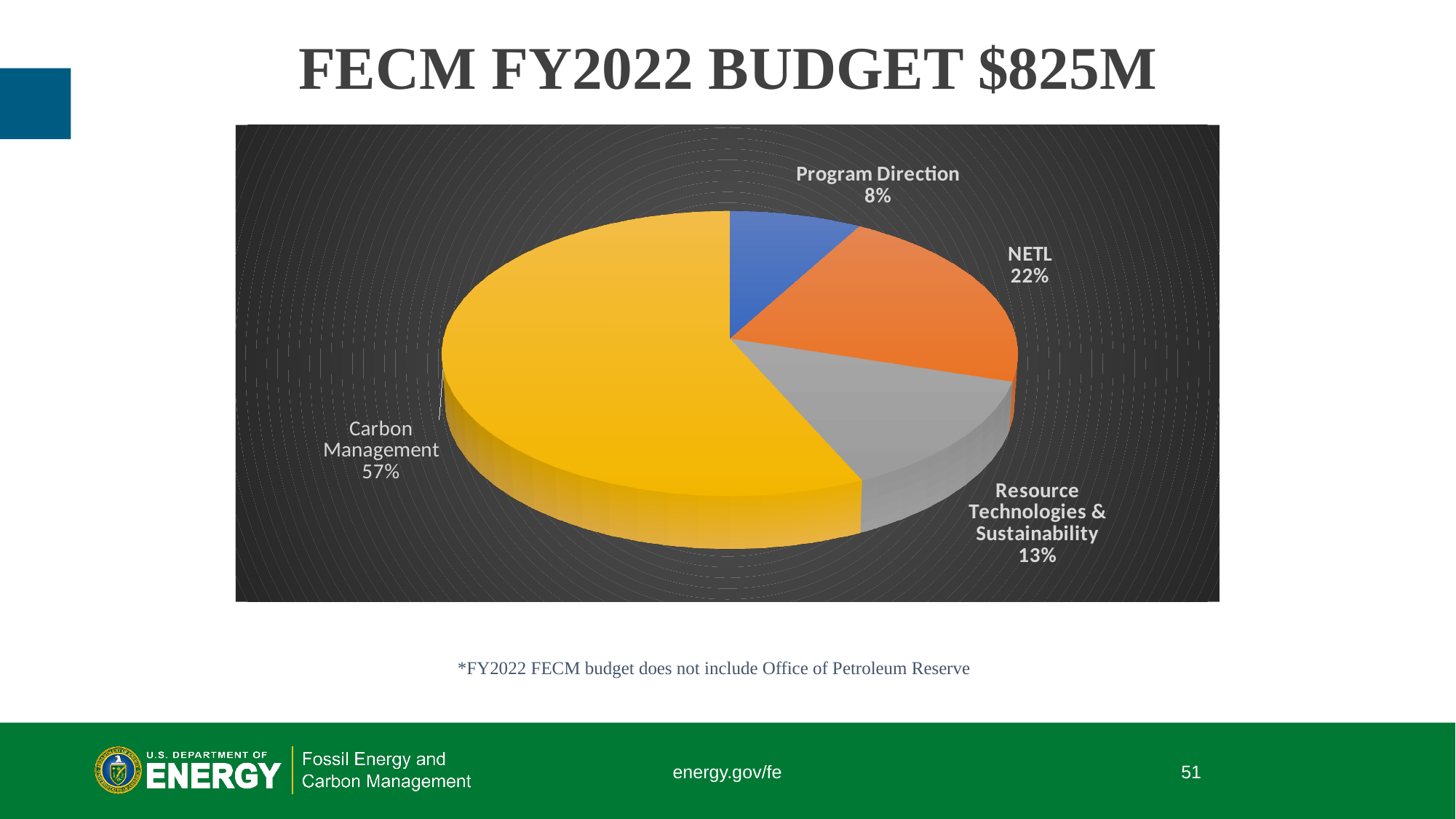
What share of the FECM FY2022 budget goes to Carbon Management? 57% What is the difference in percentage points between Carbon Management and NETL? 35 What is the difference in percentage points between Resource Technologies & Sustainability and Program Direction? 5 How many categories are shown in the pie chart? 4 What kind of chart is shown on the slide? Pie chart What percentage of the budget is for Program Direction? 8% Which category has the largest share of the budget? Carbon Management What share of the budget goes to Resource Technologies & Sustainability? 13% What is the title of the slide containing the chart? FECM FY2022 BUDGET $825M Which is larger, the share for NETL or the share for Resource Technologies & Sustainability? NETL What share of the budget is allocated to NETL? 22% Which category has the smallest share of the budget? Program Direction